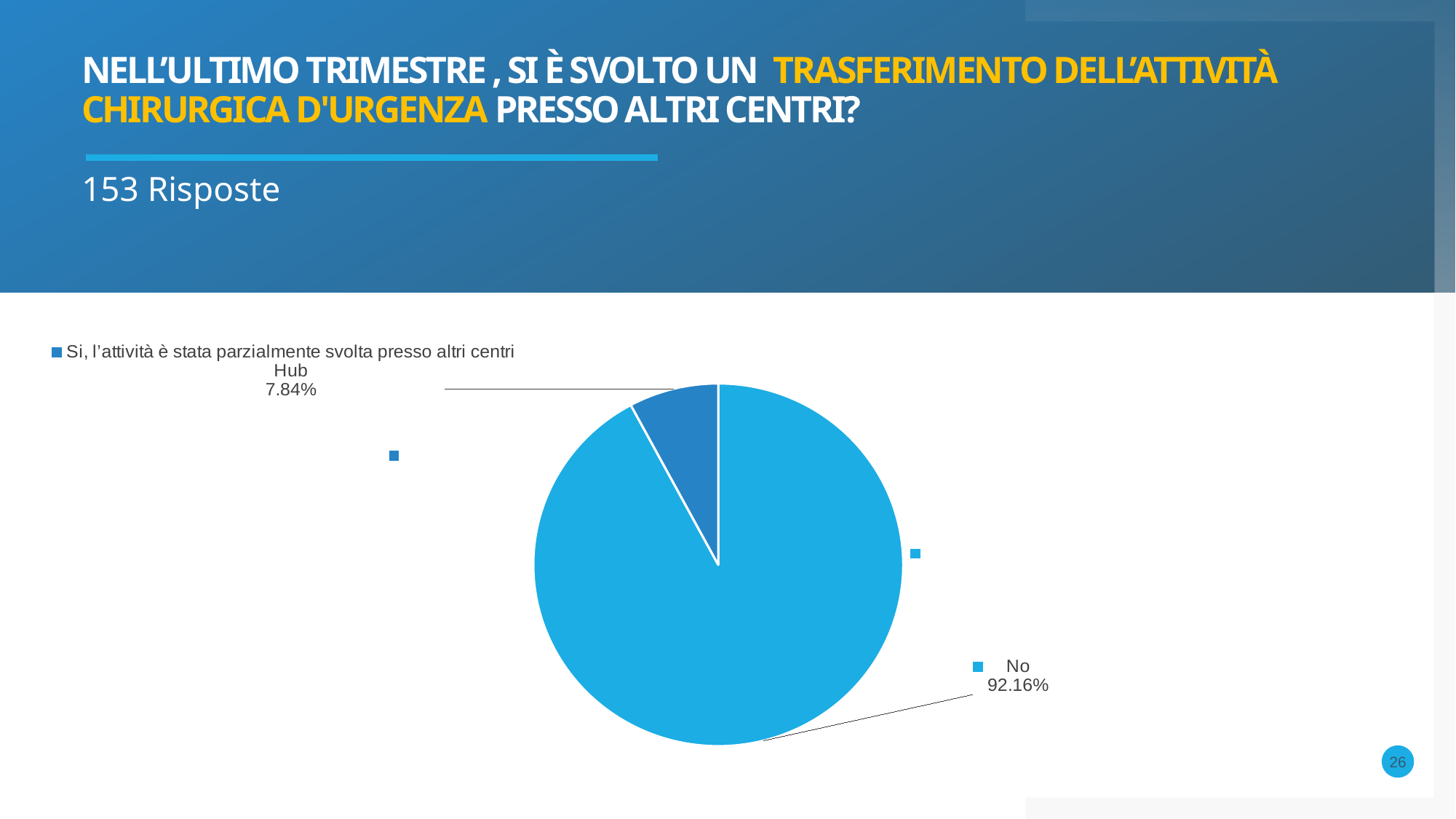
How many responses does the slide say the chart is based on? 153 Which slice of the pie chart is the largest? No What kind of chart is shown on the slide? pie chart How many slices does the pie chart have? 2 Which slice of the pie chart is the smallest? Si, l'attività è stata parzialmente svolta presso altri centri Hub What is the share of the pie taken by the "No" slice? 92.16% What percentage of the pie chart is the "No" slice? 92.16% What is the difference in percentage points between the "No" slice and the "Si, l'attività è stata parzialmente svolta presso altri centri Hub" slice? 84.32 Which is larger: the "No" slice or the "Si, l'attività è stata parzialmente svolta presso altri centri Hub" slice? No What percentage of the pie chart is the "Si, l'attività è stata parzialmente svolta presso altri centri Hub" slice? 7.84%